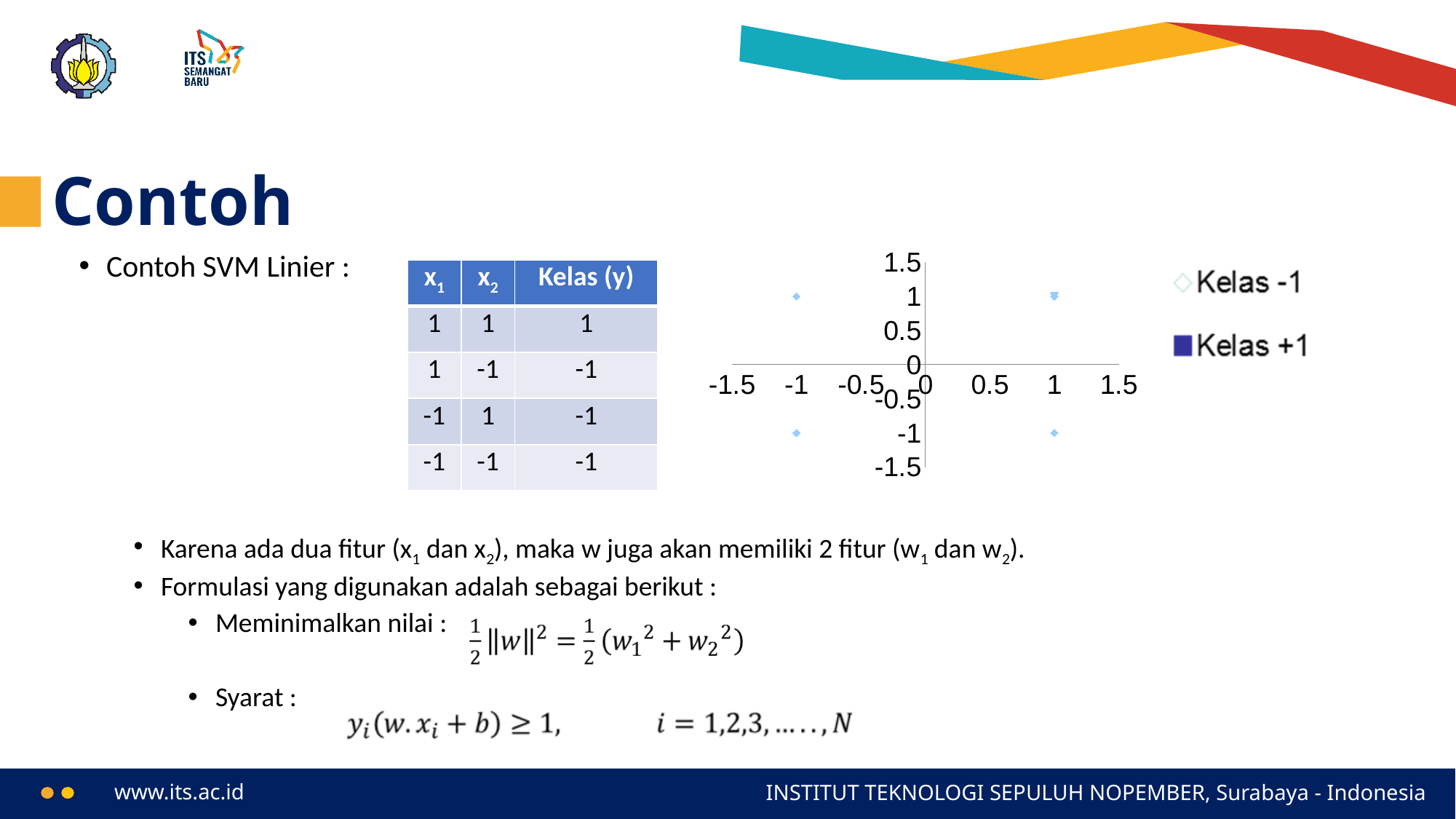
What is the x2 value of the point plotted at x1 = 1 in the upper right of the chart? 1 What is the x2 value of the point plotted at x1 = -1 in the lower left of the chart? -1 What is the highest value shown on the chart's vertical axis? 1.5 What are the two series named in the chart legend? Kelas -1 and Kelas +1 Is the x2 value of the point in the lower right of the chart greater or less than 0? less How many data points are plotted on the chart? 4 What kind of chart is shown on the slide? scatter chart What is the lowest value shown on the chart's horizontal axis? -1.5 Is the x1 value of the point in the upper left of the chart greater or less than 0? less How many series does the chart legend list? 2